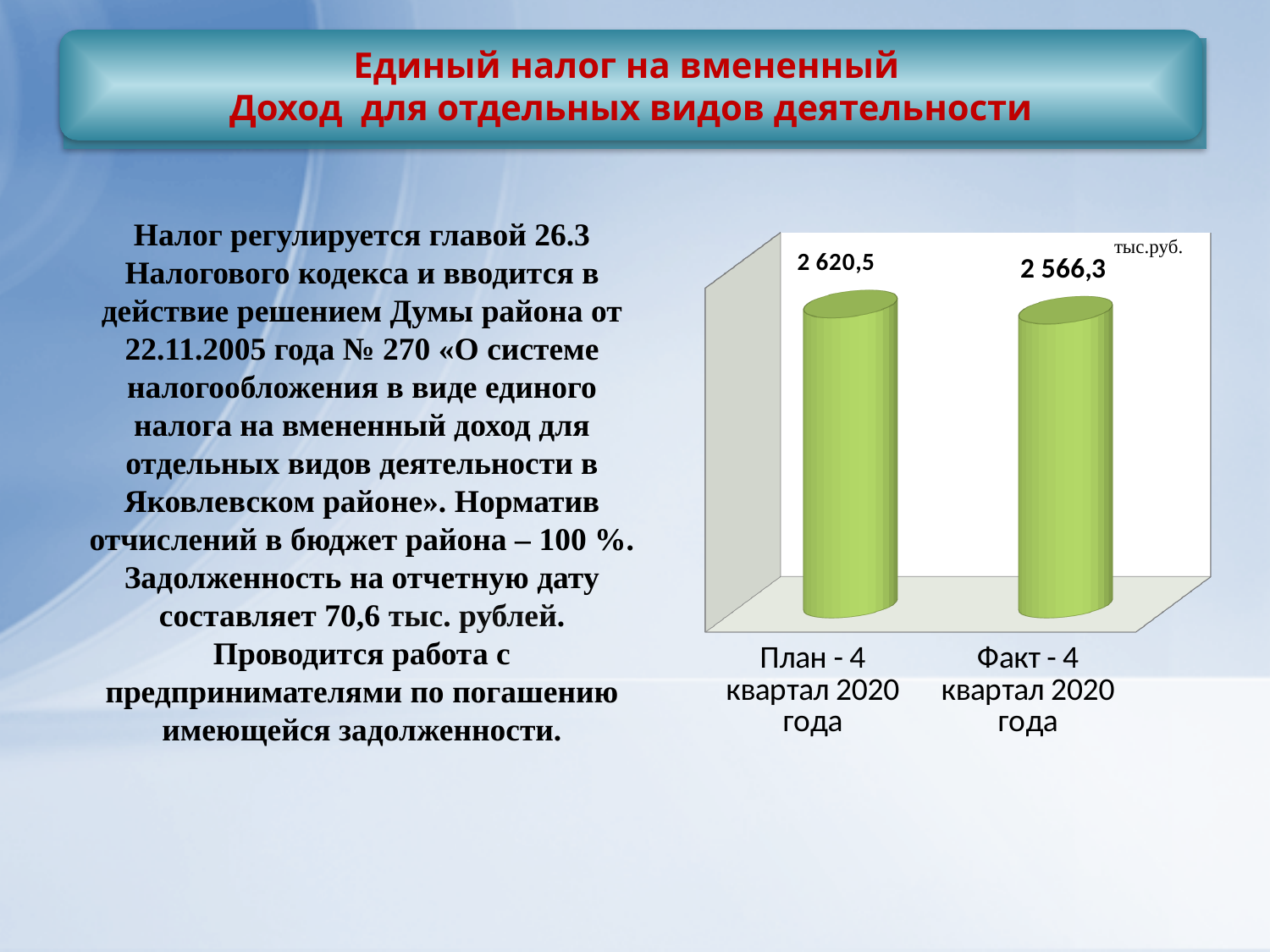
Which category has the lowest value? Факт - 4 квартал 2020 года How many bars are shown in the chart? 2 Which is larger, the План value or the Факт value? План - 4 квартал 2020 года What is the value for Факт - 4 квартал 2020 года? 2 566,3 Which category has the highest value? План - 4 квартал 2020 года What is the difference between the План and Факт values for 4 квартал 2020 года? 54,2 Do the values rise or fall from План to Факт? Fall What unit is indicated in the top right corner of the chart? тыс.руб. What kind of chart is shown on the slide? Bar chart What colour are the bars in the chart? Green What is the value for План - 4 квартал 2020 года? 2 620,5